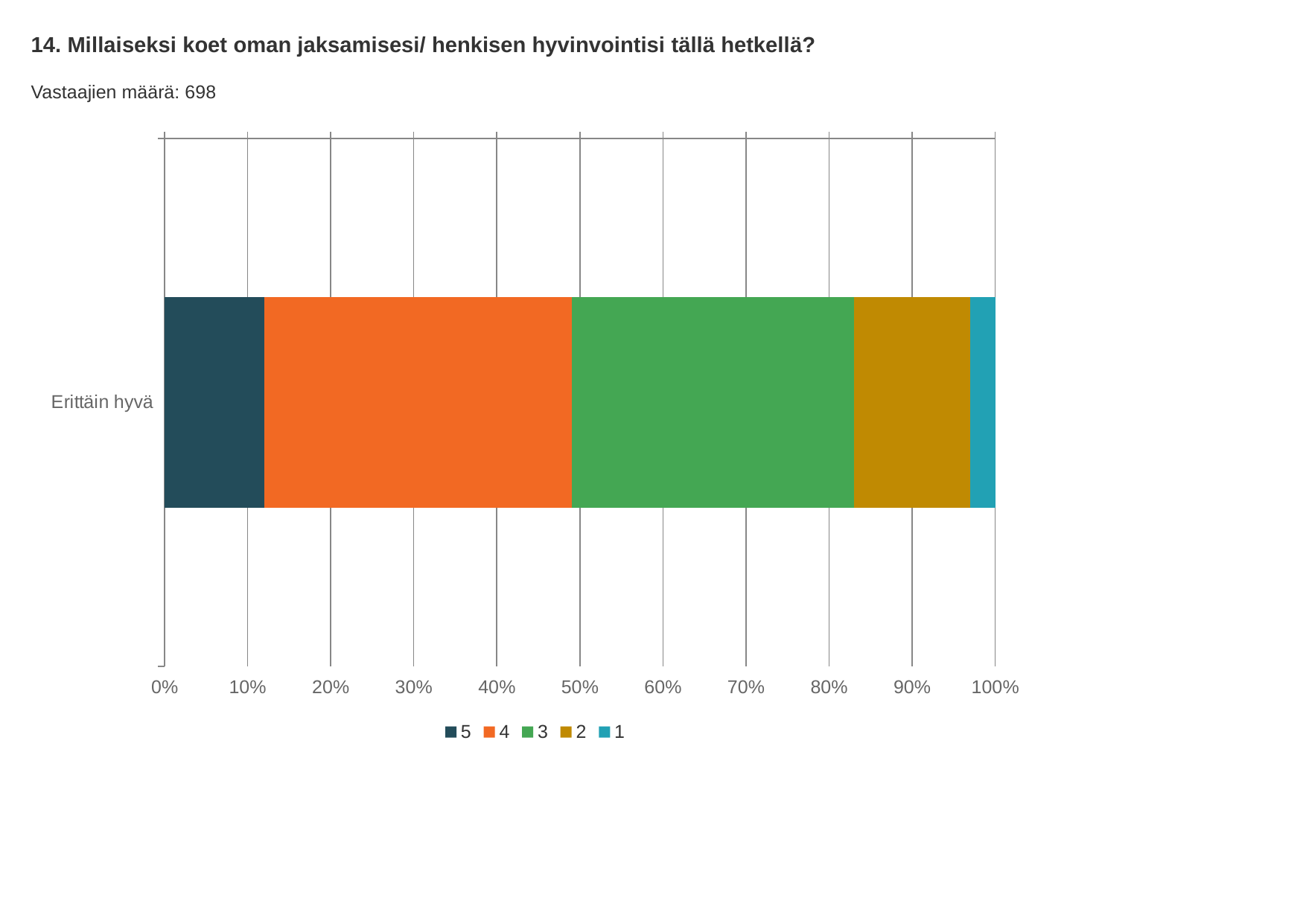
Which series has the smallest segment in the Erittäin hyvä bar? 1 What is the number of respondents (Vastaajien määrä) stated on the slide? 698 Is the share of series 5 in the Erittäin hyvä bar greater or less than 20%? less Which segment is larger in the Erittäin hyvä bar, series 4 or series 5? 4 What is the total of the stacked Erittäin hyvä bar? 100% How many series does the legend list? 5 Is the share of series 4 in the Erittäin hyvä bar greater or less than 30%? greater Is the share of series 1 in the Erittäin hyvä bar greater or less than 10%? less What is the label of the single category on the y axis? Erittäin hyvä What kind of chart is shown on the slide? Stacked bar chart Which segment is larger in the Erittäin hyvä bar, series 3 or series 2? 3 How many categories are plotted on the y axis? 1